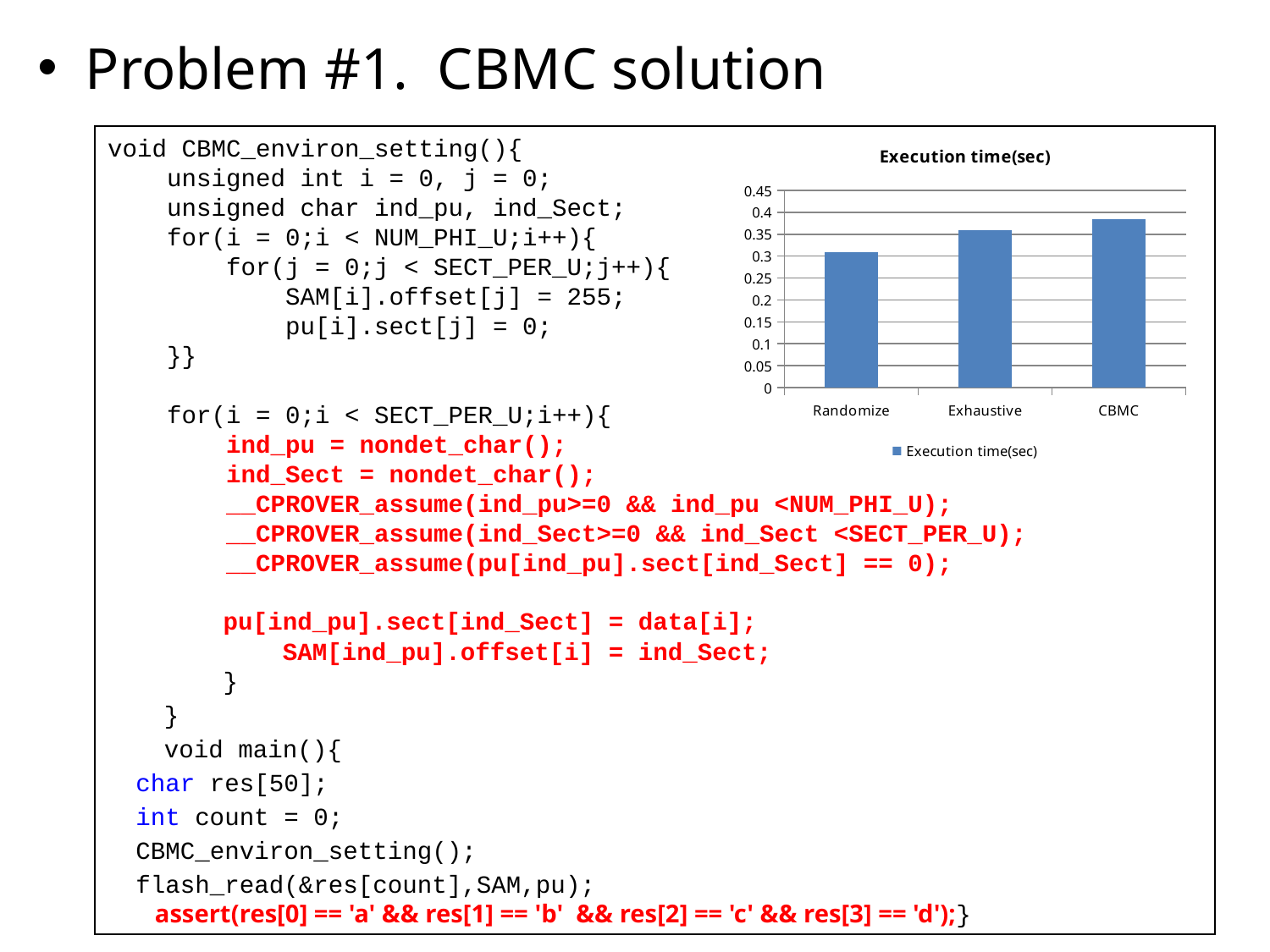
Which has a larger execution time, Randomize or Exhaustive? Exhaustive What kind of chart is shown on the slide? bar chart Is the value for Randomize greater or less than 0.35? less Is the value for Exhaustive greater or less than 0.4? less Do the execution times rise or fall from Randomize to CBMC along the x axis? rise How many categories are plotted in the chart? 3 Which has a larger execution time, Randomize or CBMC? CBMC Which category has the highest execution time? CBMC How many series does the chart's legend list? 1 Which category has the lowest execution time? Randomize Is the value for CBMC greater or less than 0.35? greater What is the title of the chart? Execution time(sec)